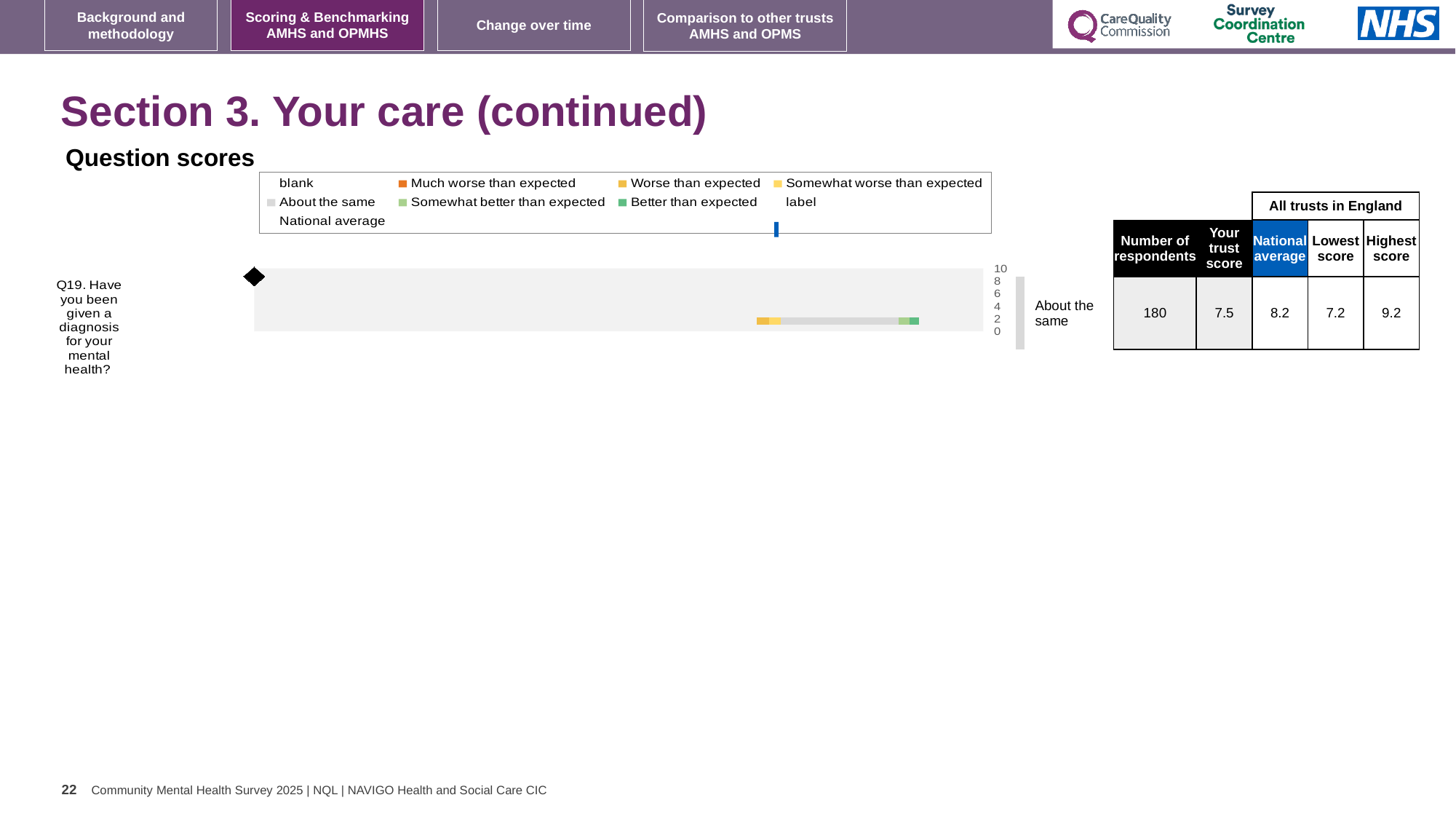
What is the difference between the national average and your trust score for Q19? 0.7 What is your trust score for Q19? 7.5 What is the number of respondents for Q19? 180 What benchmark category is shown next to the bar for Q19? About the same Which question is plotted in the Question scores chart? Q19. Have you been given a diagnosis for your mental health? How many questions are plotted in the Question scores chart? 1 Which is larger for Q19, your trust score or the national average? national average What kind of chart is shown under 'Question scores'? bar chart What is the difference between the highest score and the lowest score for Q19? 2.0 What is the highest score among all trusts in England for Q19? 9.2 What is the lowest score among all trusts in England for Q19? 7.2 What is the national average for Q19? 8.2